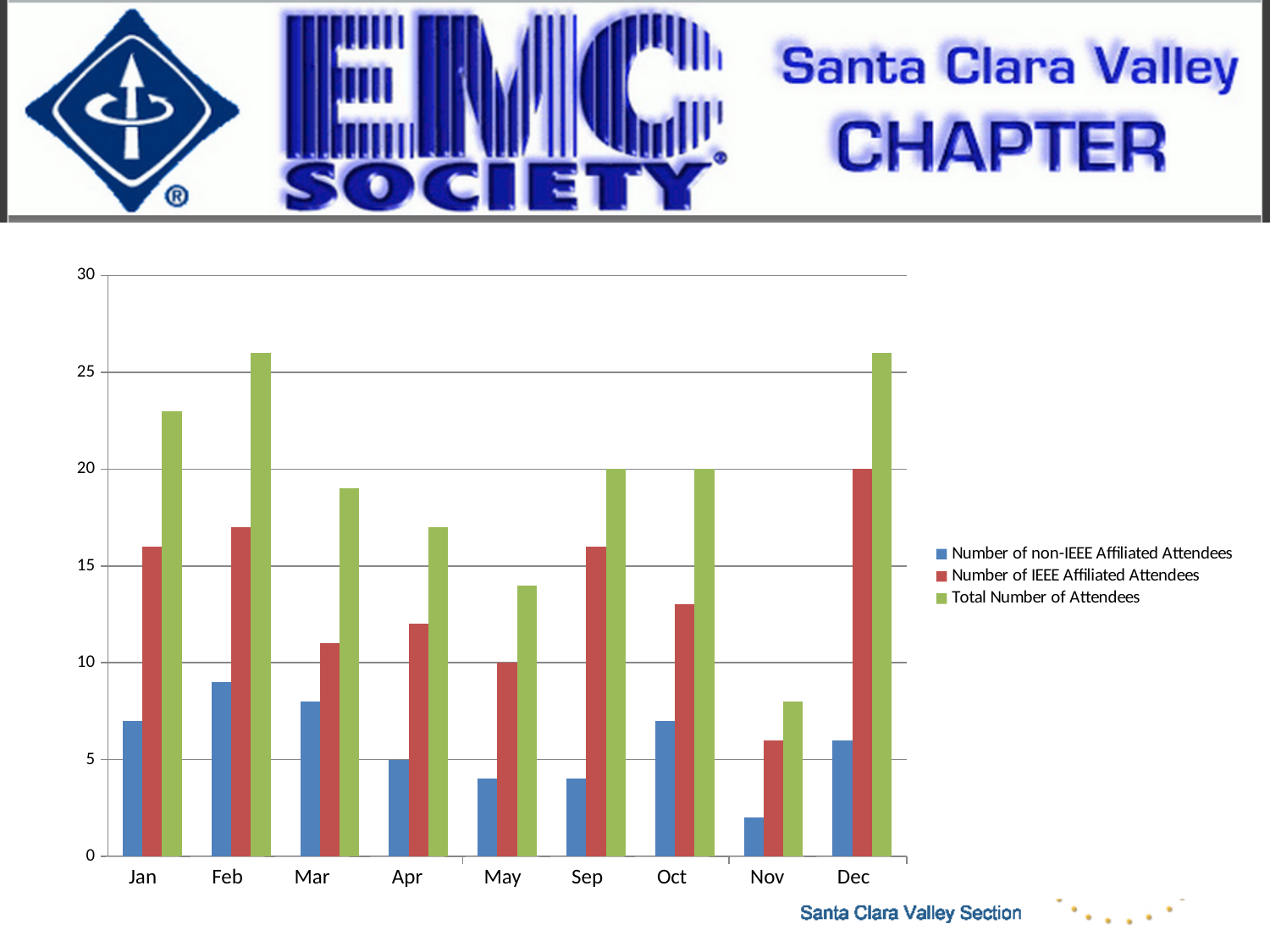
What is the Number of IEEE Affiliated Attendees for May? 10 What is the Total Number of Attendees for Sep? 20 Which month has the highest Number of IEEE Affiliated Attendees? Dec What is the Number of IEEE Affiliated Attendees for Dec? 20 Which is larger, the Number of IEEE Affiliated Attendees in Jan or in Mar? Jan What kind of chart is shown on the slide? bar chart How many months are shown on the x axis? 9 Which month has the lowest Number of non-IEEE Affiliated Attendees? Nov Which month has the lowest Total Number of Attendees? Nov Is the Total Number of Attendees for Feb greater or less than 25? greater What colour represents Total Number of Attendees in the legend? green How many series does the legend list? 3